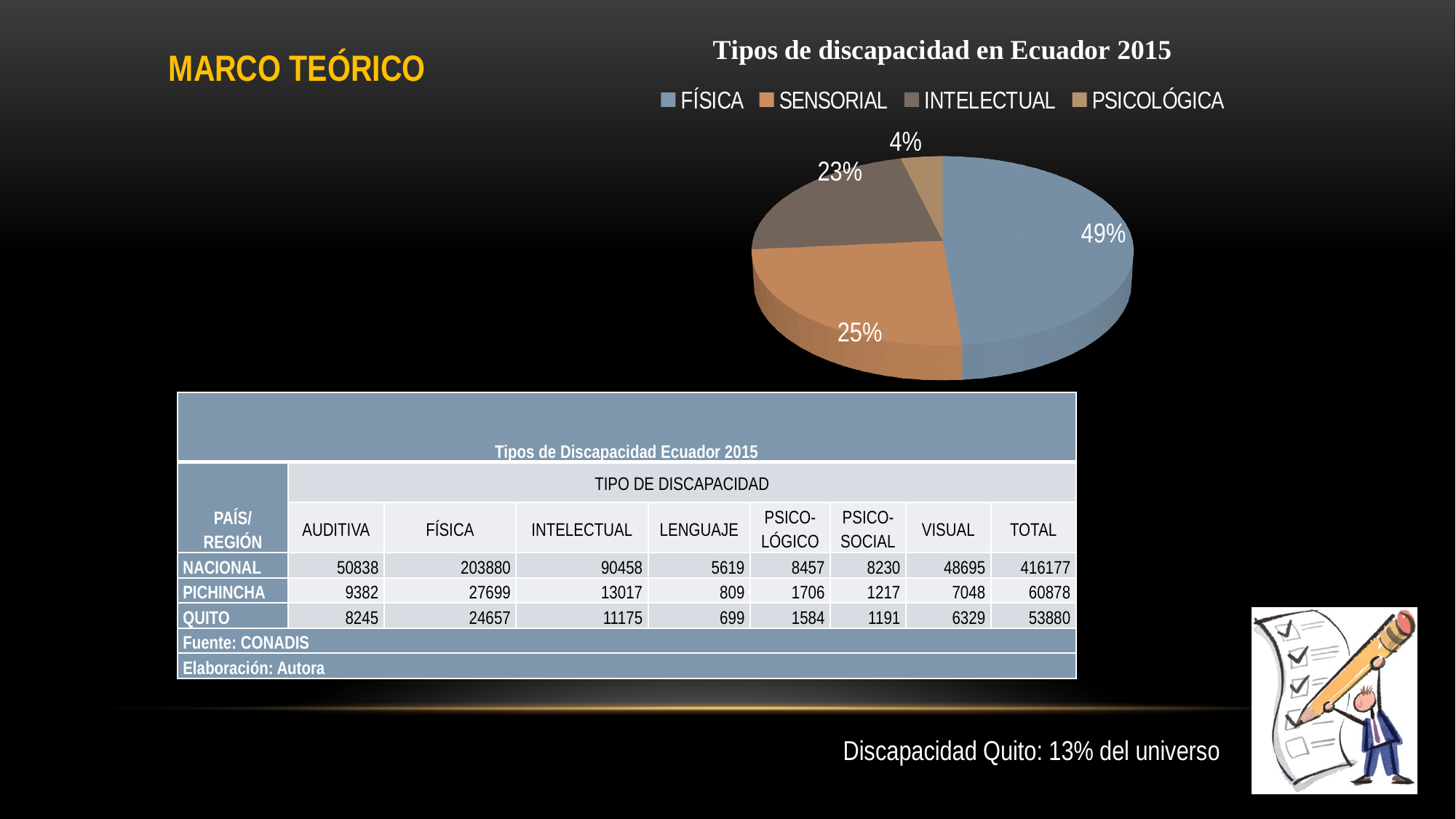
In the pie chart, what percentage is shown for INTELECTUAL? 23% What is the title of the pie chart? Tipos de discapacidad en Ecuador 2015 What type of chart is shown under the title 'Tipos de discapacidad en Ecuador 2015'? pie chart How many categories does the pie chart's legend list? 4 In the pie chart, what percentage is shown for PSICOLÓGICA? 4% In the pie chart, what is the difference in percentage points between FÍSICA and SENSORIAL? 24 In the pie chart, which is larger, SENSORIAL or INTELECTUAL? SENSORIAL Which category has the smallest slice in the pie chart? PSICOLÓGICA In the pie chart, what colour is the FÍSICA slice? blue In the pie chart, what percentage is shown for SENSORIAL? 25% In the pie chart, what percentage is shown for FÍSICA? 49% Which category has the largest slice in the pie chart? FÍSICA